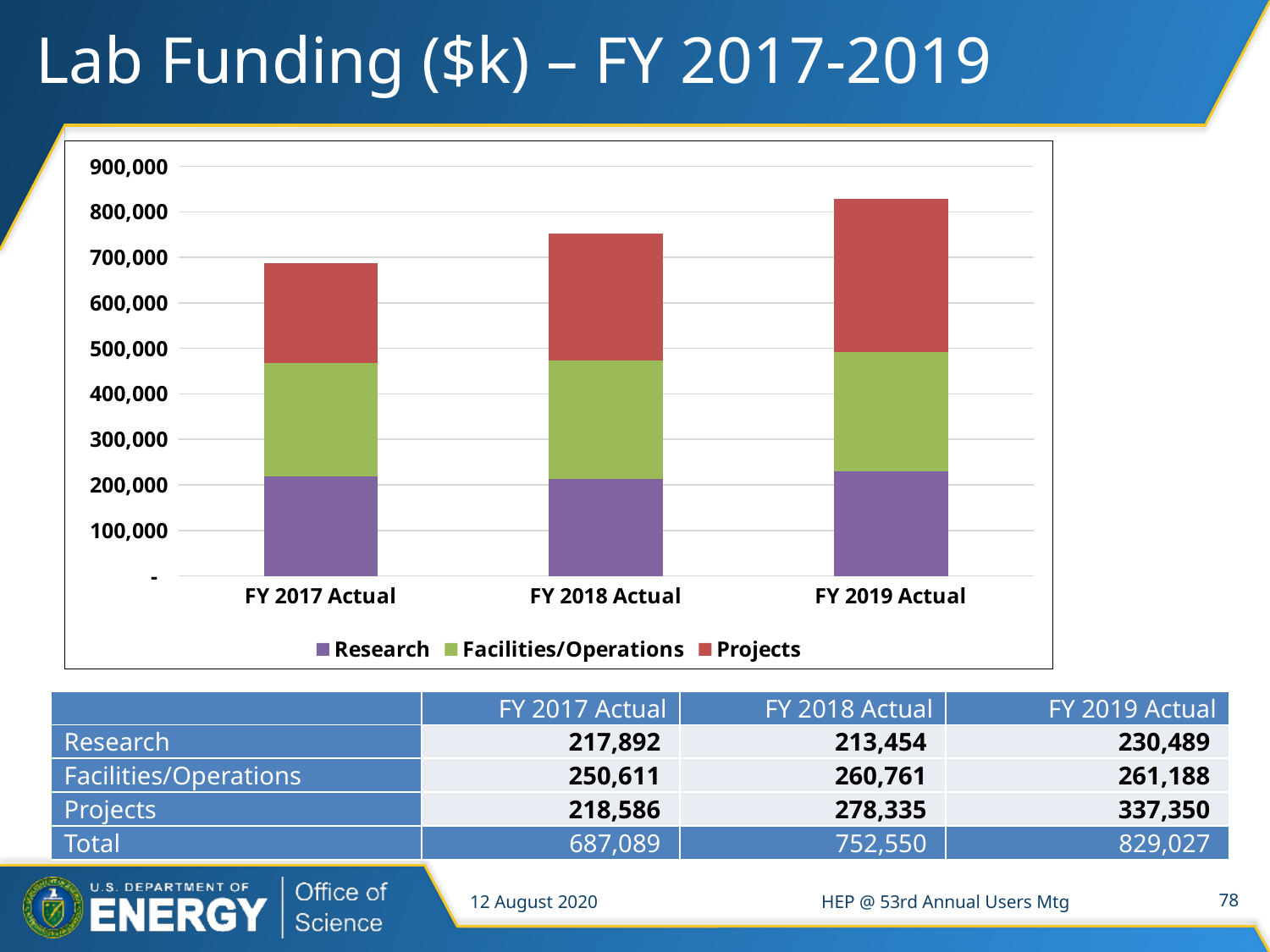
How many fiscal year categories are plotted on the x axis? 3 What is the Facilities/Operations value for FY 2017 Actual? 250,611 What is the Projects value for FY 2019 Actual? 337,350 What is the difference between the Projects values for FY 2019 Actual and FY 2018 Actual? 59,015 What is the Research value for FY 2018 Actual? 213,454 Which fiscal year has the lowest Projects value? FY 2017 Actual How many series does the chart legend list? 3 Do the total funding values rise or fall from FY 2017 to FY 2019? Rise What kind of chart is shown on the slide? Stacked bar chart What is the total of the stacked bar for FY 2019 Actual? 829,027 Is the total for FY 2018 Actual greater or less than 700,000? greater Which fiscal year has the highest total funding? FY 2019 Actual